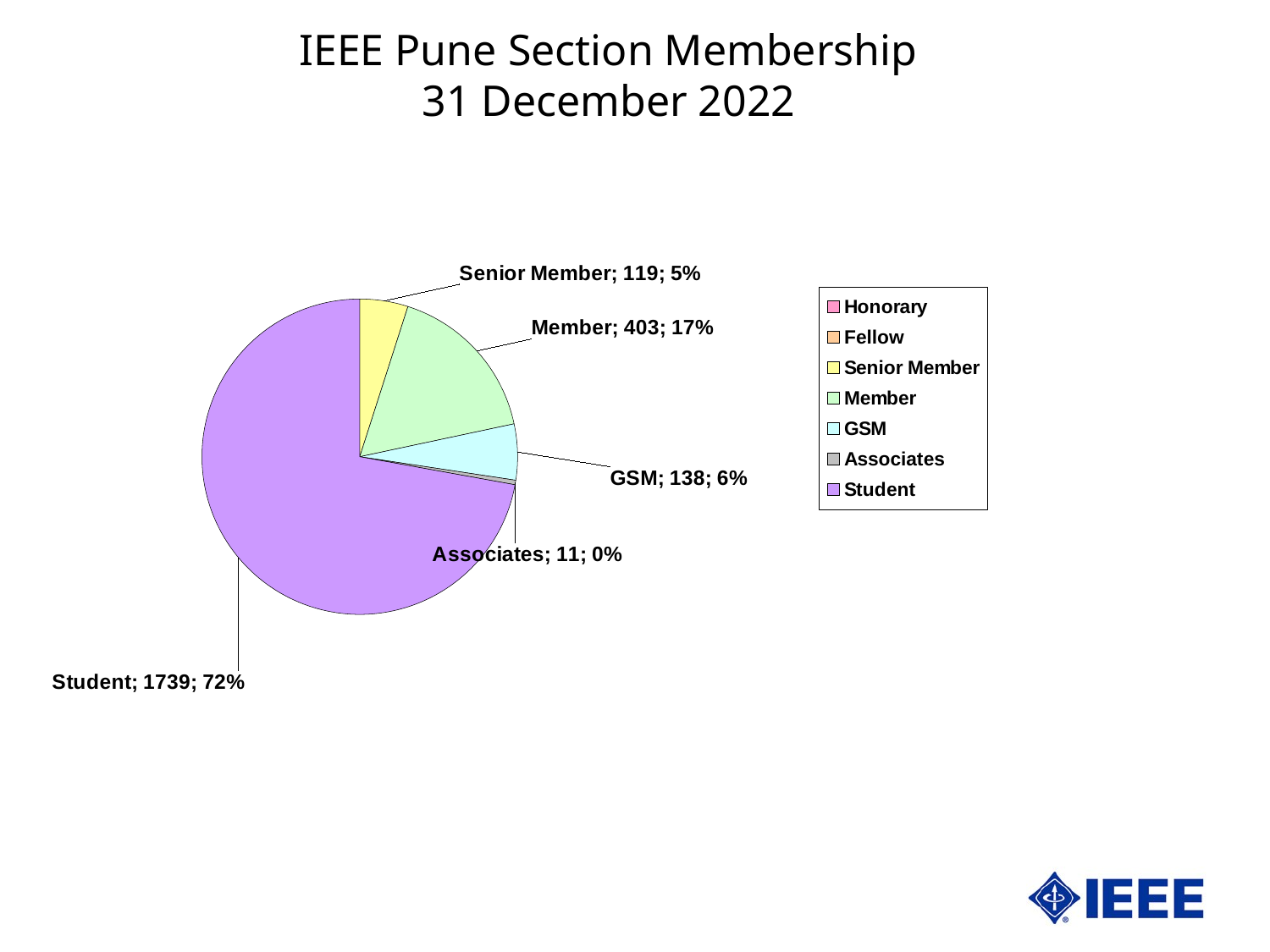
How many members does the Senior Member slice represent? 119 What kind of chart is shown on the slide? pie chart Which category has the largest slice of the pie? Student How many entries does the legend list? 7 What percentage is shown for the GSM slice? 6% What share of the pie does the Student slice represent? 72% What is the difference between the Member count and the Senior Member count? 284 How many members does the Member slice represent? 403 What value is shown for Associates? 11 Which labelled category has the smallest slice of the pie? Associates Which is larger, the GSM count or the Senior Member count? GSM How many members does the Student slice represent? 1739